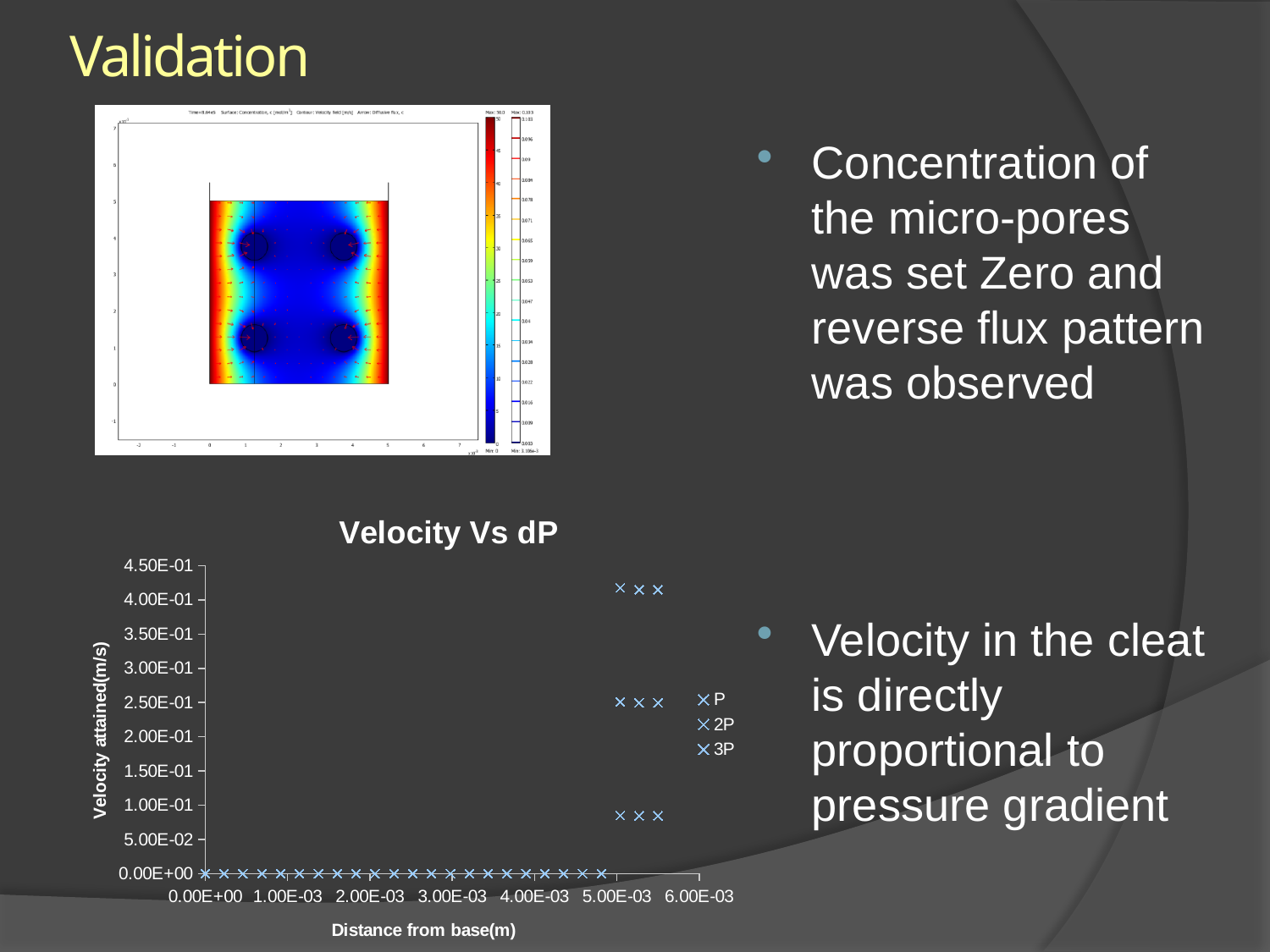
How many series does the legend of the "Velocity Vs dP" chart list? 3 In the "Velocity Vs dP" chart, what is the label of the x axis? Distance from base(m) In the "Velocity Vs dP" chart, is the velocity of the highest cluster of points greater or less than 4.00E-01? greater In the "Velocity Vs dP" chart, what is the label of the y axis? Velocity attained(m/s) What is the title of the chart at the bottom of the slide? Velocity Vs dP In the "Velocity Vs dP" chart, is the velocity of the lowest non-zero cluster of points greater or less than 1.00E-01? less In the "Velocity Vs dP" chart, is the velocity of the lowest non-zero cluster of points greater or less than 5.00E-02? greater In the "Velocity Vs dP" chart, do the plotted velocities stay at zero or rise for distances below 4.00E-03? stay at zero What kind of chart is the "Velocity Vs dP" chart? scatter chart In the "Velocity Vs dP" chart, what is the highest tick value shown on the y axis? 4.50E-01 In the "Velocity Vs dP" chart, what is the highest tick value shown on the x axis? 6.00E-03 What are the legend entries in the "Velocity Vs dP" chart? P, 2P, 3P